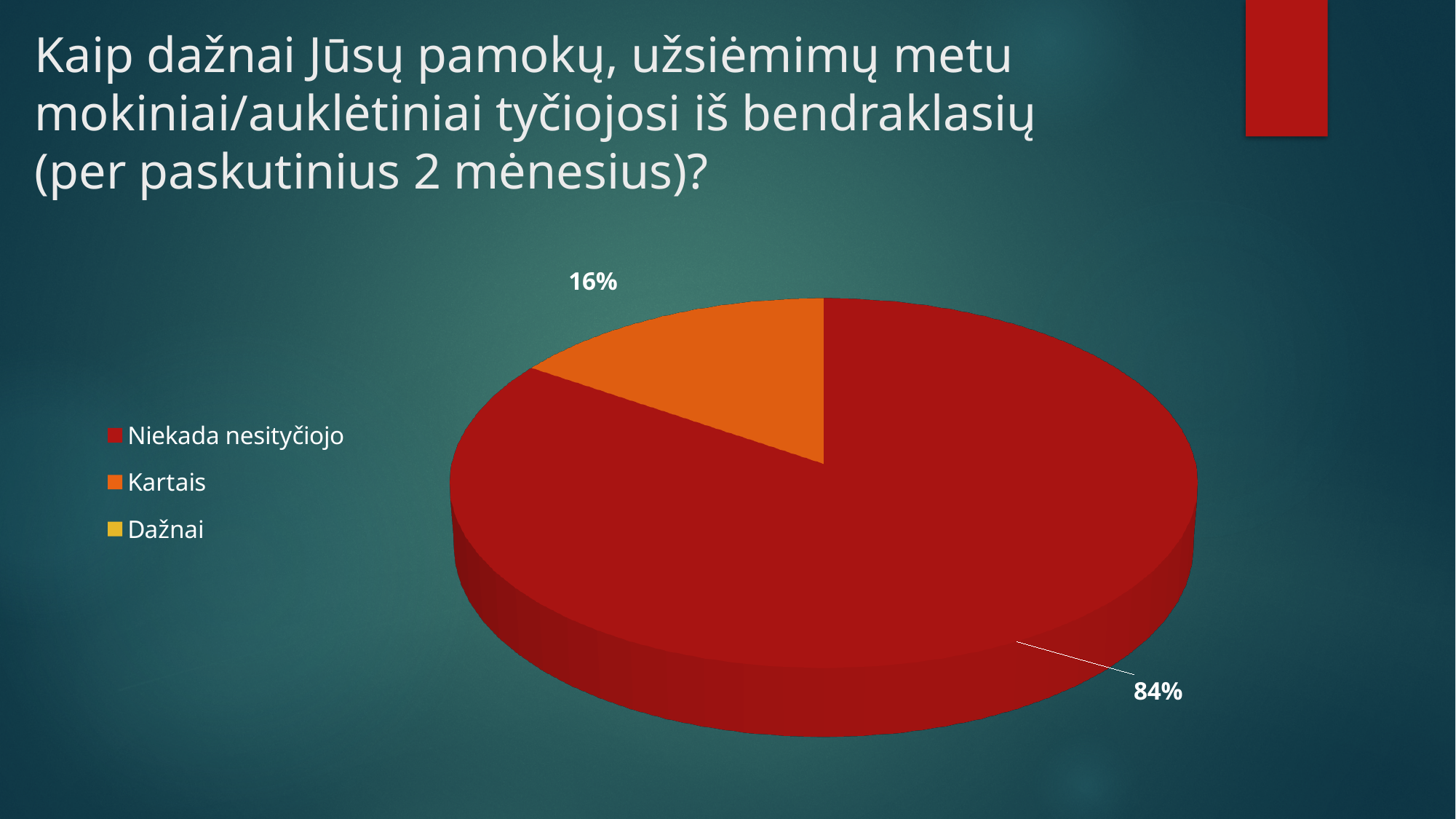
Which legend entry is shown in yellow? Dažnai By how many percentage points does the 'Niekada nesityčiojo' slice exceed the 'Kartais' slice? 68 percentage points What share of the pie does the 'Kartais' slice represent? 16% What percentage of the pie chart is labelled for the 'Kartais' slice? 16% Which category has the largest slice of the pie chart? Niekada nesityčiojo Which legend entry is shown in orange? Kartais Which of the two labelled slices is larger, 'Niekada nesityčiojo' or 'Kartais'? Niekada nesityčiojo How many categories does the legend of the chart list? 3 What percentage of the pie chart is labelled for the 'Niekada nesityčiojo' slice? 84% Is the share for 'Niekada nesityčiojo' greater or less than 50%? greater What kind of chart is shown on the slide? Pie chart